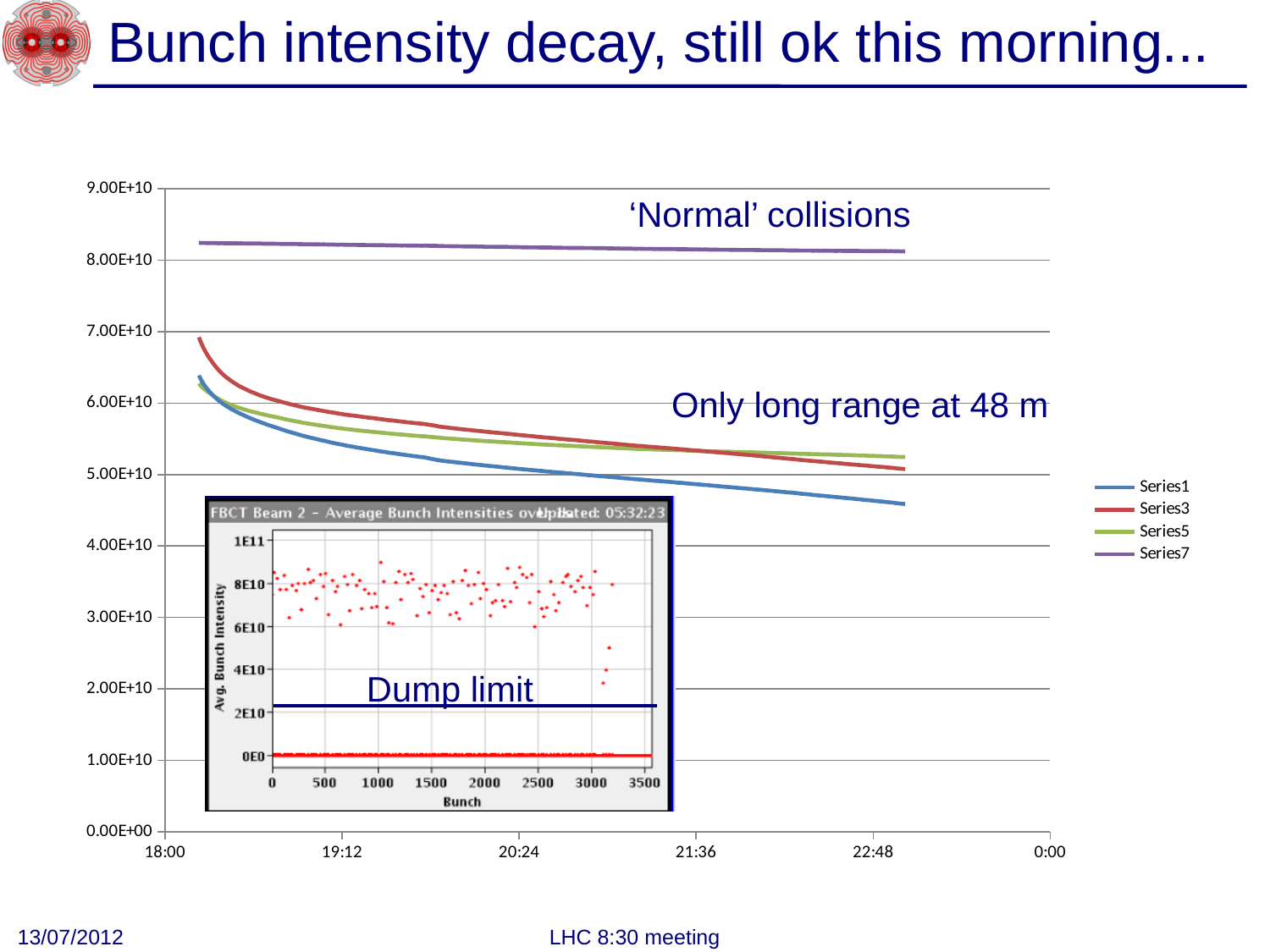
In the main chart, which is larger at the start of the lines: Series3 or Series1? Series3 What is the first time label on the x axis of the main chart? 18:00 In the main chart, is the starting value of Series3 (near 18:00) greater or less than 6.00E+10? greater How many series does the legend of the main chart list? 4 In the main chart, is the final value of Series1 (near 22:48) greater or less than 5.00E+10? less In the main chart, which series has the lowest value at the right end of the lines? Series1 What kind of chart is the main chart on the slide? line chart In the main chart, which series has the highest values throughout? Series7 In the main chart, is the value of Series7 greater or less than 8.00E+10? greater What is the y-axis label of the inset chart in the lower part of the slide? Avg. Bunch Intensity In the main chart, does Series1 rise or fall over time along the x axis? fall